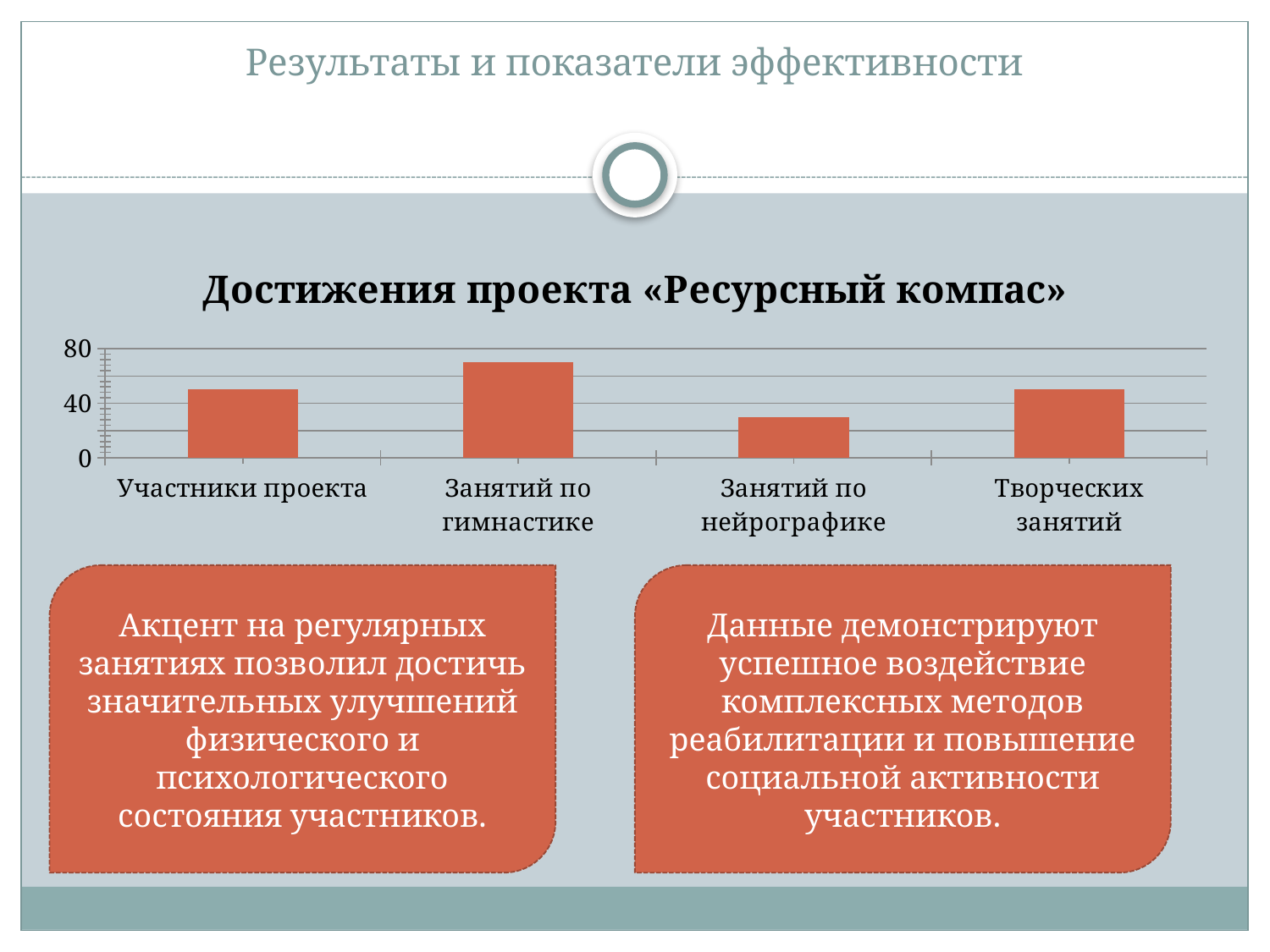
How many categories are shown on the x axis of the chart? 4 Which category has the lowest bar? Занятий по нейрографике What is the highest value labelled on the vertical axis of the chart? 80 What kind of chart is shown on the slide? bar chart Is the value for Занятий по гимнастике greater or less than 40? greater Which is larger: the value for Занятий по гимнастике or the value for Занятий по нейрографике? Занятий по гимнастике Is the value for Участники проекта greater or less than 40? greater Which category has the highest bar? Занятий по гимнастике What is the title of the chart? Достижения проекта «Ресурсный компас» Which is larger: the value for Участники проекта or the value for Занятий по нейрографике? Участники проекта Is the value for Творческих занятий greater or less than 80? less